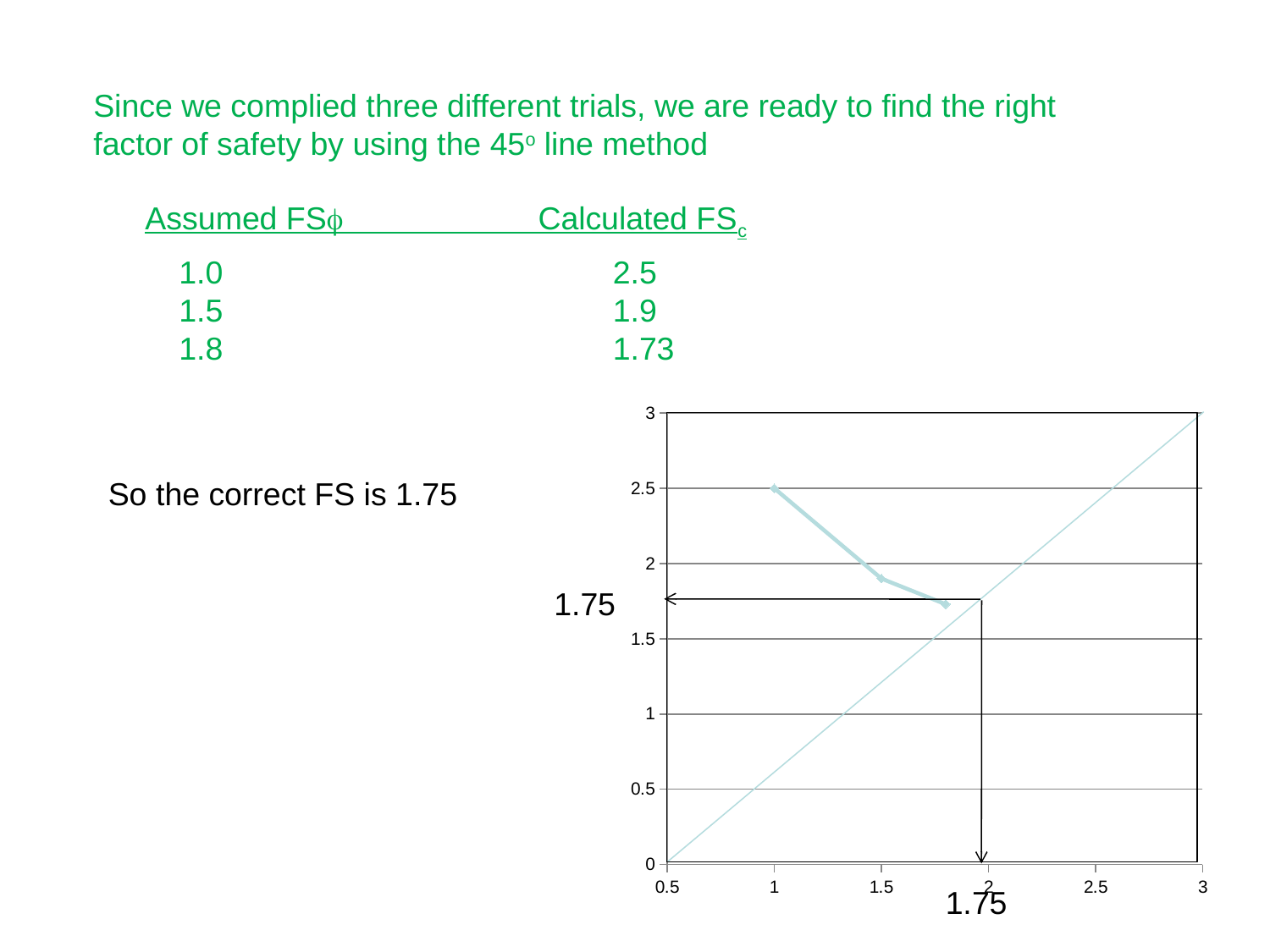
Which has the larger calculated FS: assumed FS 1.0 or assumed FS 1.8? 1.0 What is the difference between the calculated FS at assumed FS 1.0 and at assumed FS 1.5? 0.6 What kind of chart is shown on the slide? line chart Is the plotted value at assumed FS 1.0 greater or less than 2? greater What is the highest tick value shown on the y axis of the chart? 3 Do the plotted calculated FS values rise or fall as the assumed FS increases along the x axis? fall What is the calculated FS plotted for an assumed FS of 1.5? 1.9 At which assumed FS is the plotted calculated FS lowest? 1.8 At which assumed FS is the plotted calculated FS highest? 1.0 What value is marked by the arrows where the curve meets the 45° line? 1.75 How many data points are plotted on the curve of calculated FS versus assumed FS? 3 What is the calculated FS plotted for an assumed FS of 1.8? 1.73